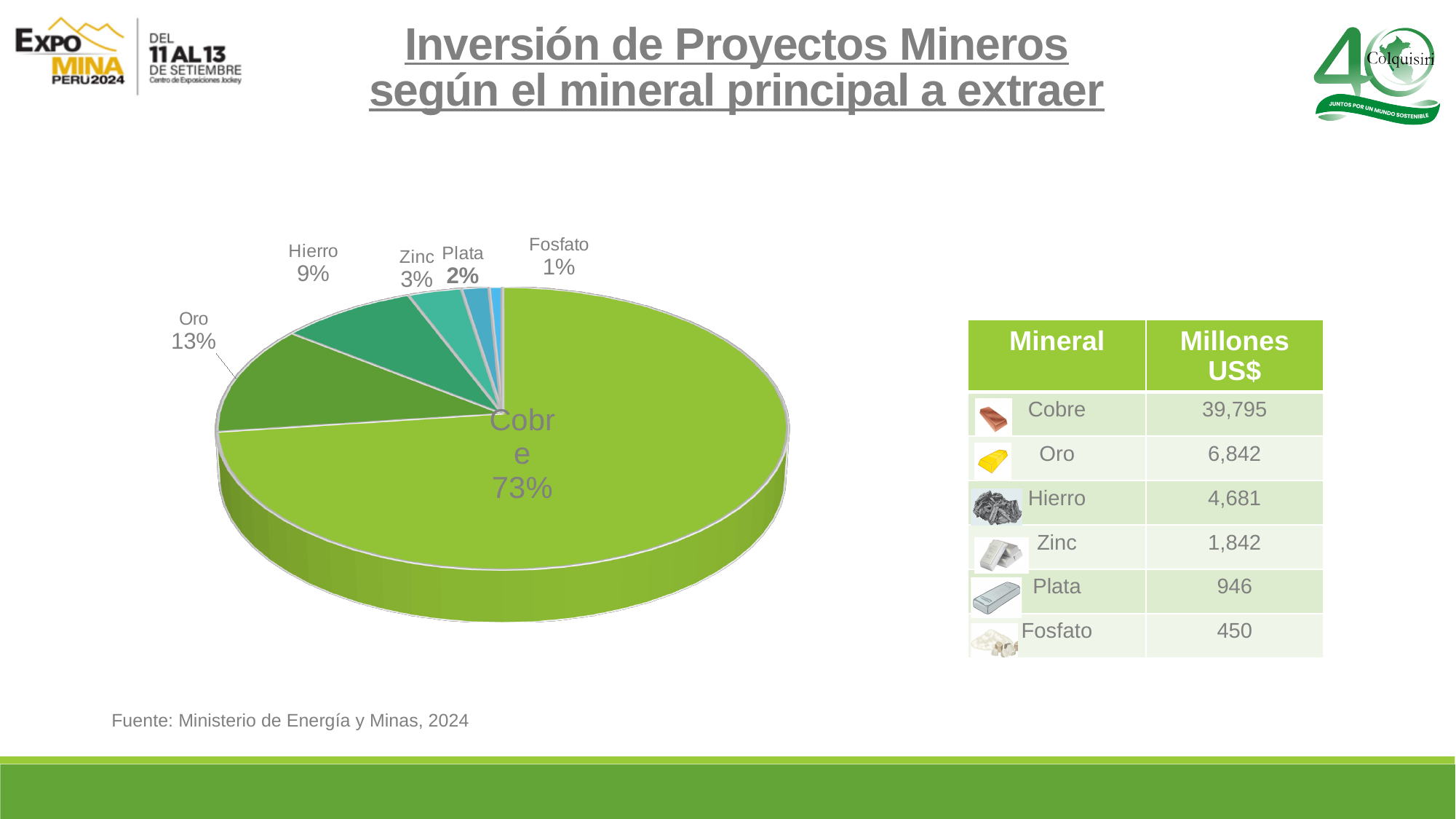
What kind of chart is shown on the slide? Pie chart Which mineral has the largest slice of the pie? Cobre What share of the pie does Fosfato represent? 1% Which mineral has the smallest slice of the pie? Fosfato What share of the pie does Hierro represent? 9% What share of the pie does Oro represent? 13% What is the title of the slide containing the pie chart? Inversión de Proyectos Mineros según el mineral principal a extraer Which slice is larger, Oro or Hierro? Oro How many slices does the pie chart have? 6 What is the difference in percentage points between the Cobre and Oro slices? 60 percentage points